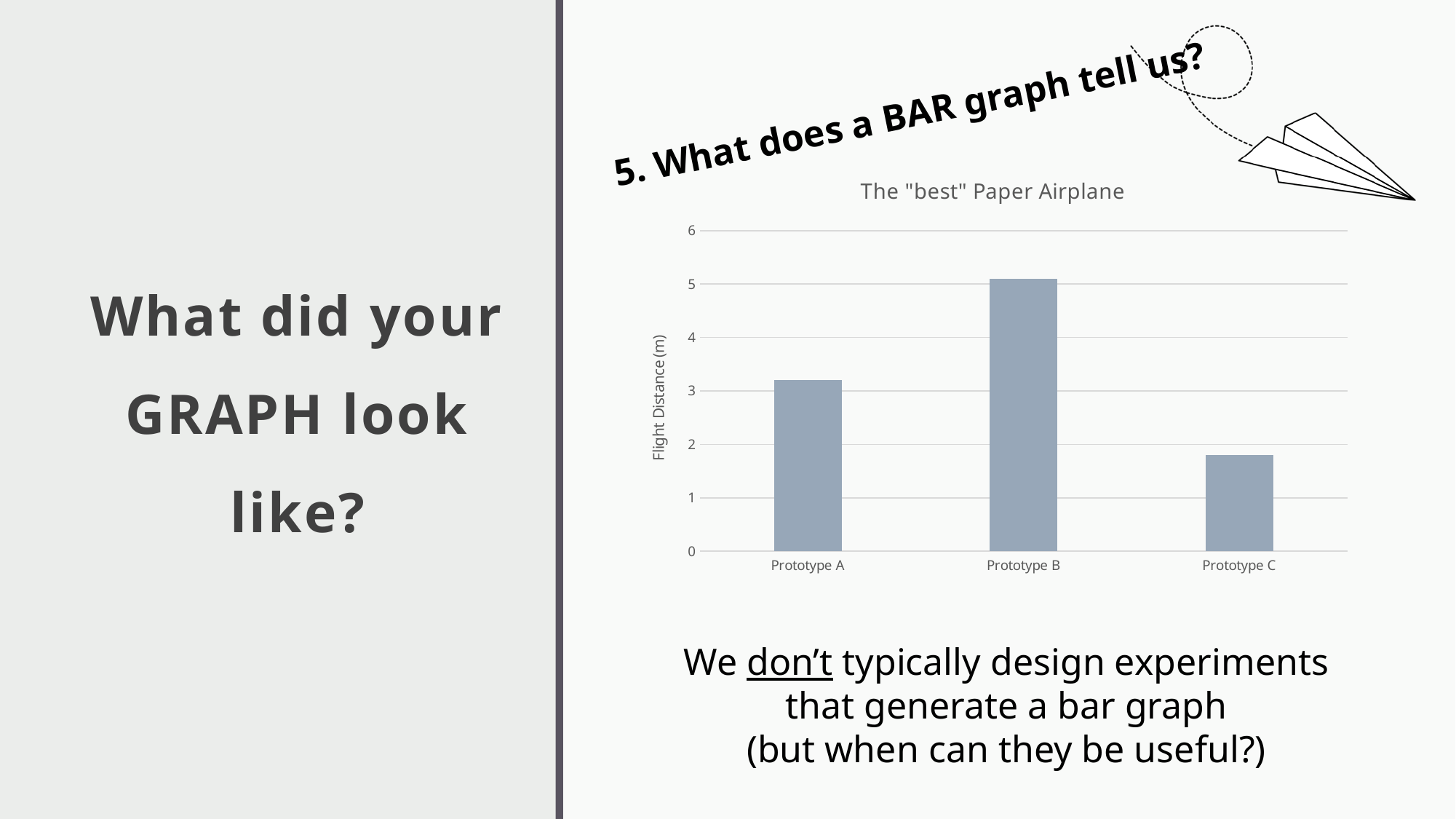
Which prototype has the highest flight distance? Prototype B What is the title of the chart? The "best" Paper Airplane Which prototype has the lowest flight distance? Prototype C Is the flight distance for Prototype A greater or less than 3? greater Which has a larger flight distance, Prototype A or Prototype C? Prototype A How many prototypes are plotted in the chart? 3 Which has a larger flight distance, Prototype B or Prototype A? Prototype B What kind of chart is shown on the slide? bar chart Is the flight distance for Prototype C greater or less than 2? less Is the flight distance for Prototype A greater or less than 4? less What is the label on the vertical axis of the chart? Flight Distance (m)